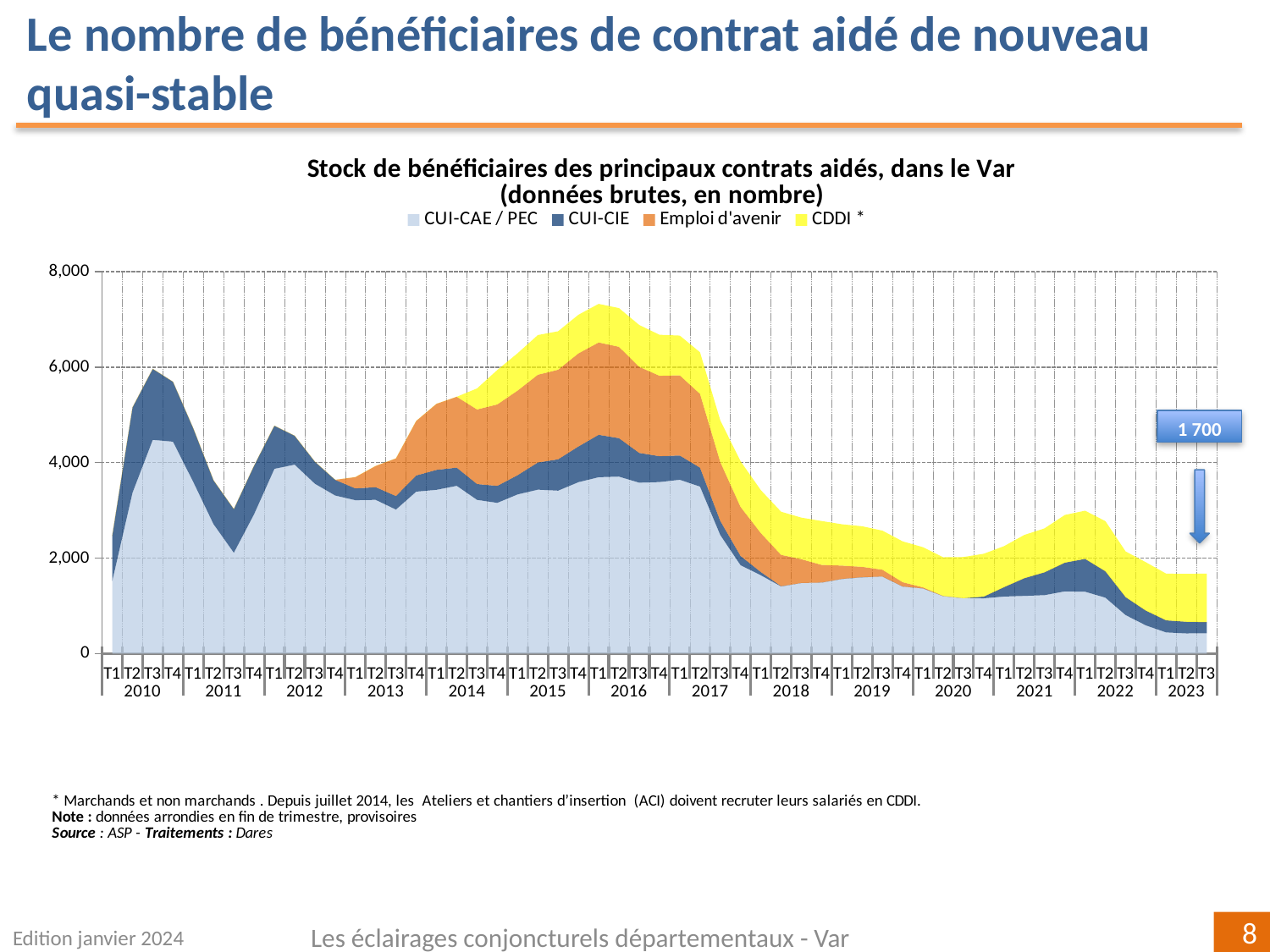
In which year does the total stock of beneficiaries reach its highest level? 2016 How many series does the chart legend list? 4 How many years are labelled along the x axis? 14 Which is larger: the total stock in T3 2010 or in T3 2023? T3 2010 Which series is shown in yellow in the legend? CDDI * What value is annotated for the latest point (T3 2023) on the chart? 1 700 Is the total stock of beneficiaries in T1 2010 greater or less than 2,000? greater Is the total stock of beneficiaries in T3 2023 greater or less than 2,000? less Does the total stock of beneficiaries rise or fall between T1 2016 and T1 2018? fall Is the total stock of beneficiaries in T1 2016 greater or less than 6,000? greater What kind of chart is shown on the slide? stacked area chart